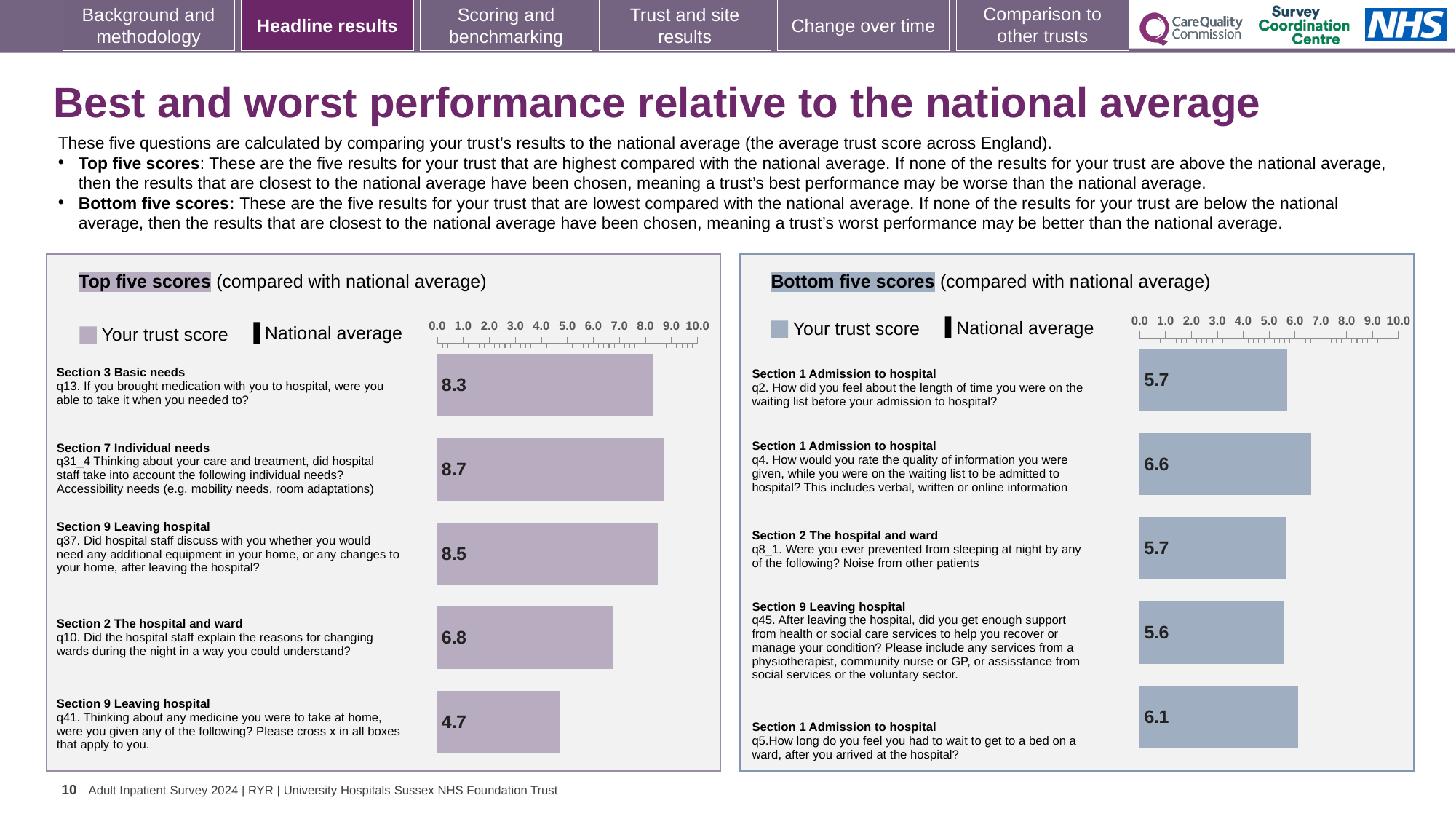
In the Top five scores chart, what is the difference between the scores for q31_4 and q41? 4.0 In the Top five scores chart, which question has the highest trust score? q31_4 (Section 7 Individual needs) How many bars are plotted in the Bottom five scores chart? 5 In the Bottom five scores chart, what is the difference between the scores for q4 and q45? 1.0 In the Bottom five scores chart, which question has the highest trust score? q4 (Section 1 Admission to hospital) In the Top five scores chart, what is the trust score for q41 (Section 9 Leaving hospital)? 4.7 In the Bottom five scores chart, which question has the lowest trust score? q45 (Section 9 Leaving hospital) In the Top five scores chart, which has the larger score: q13 or q37? q37 What type of chart is the Top five scores chart? Bar chart In the Bottom five scores chart, what is the trust score for q4 (Section 1 Admission to hospital)? 6.6 In the Top five scores chart, what is the trust score for q13 (Section 3 Basic needs)? 8.3 In the Top five scores chart, which question has the lowest trust score? q41 (Section 9 Leaving hospital)